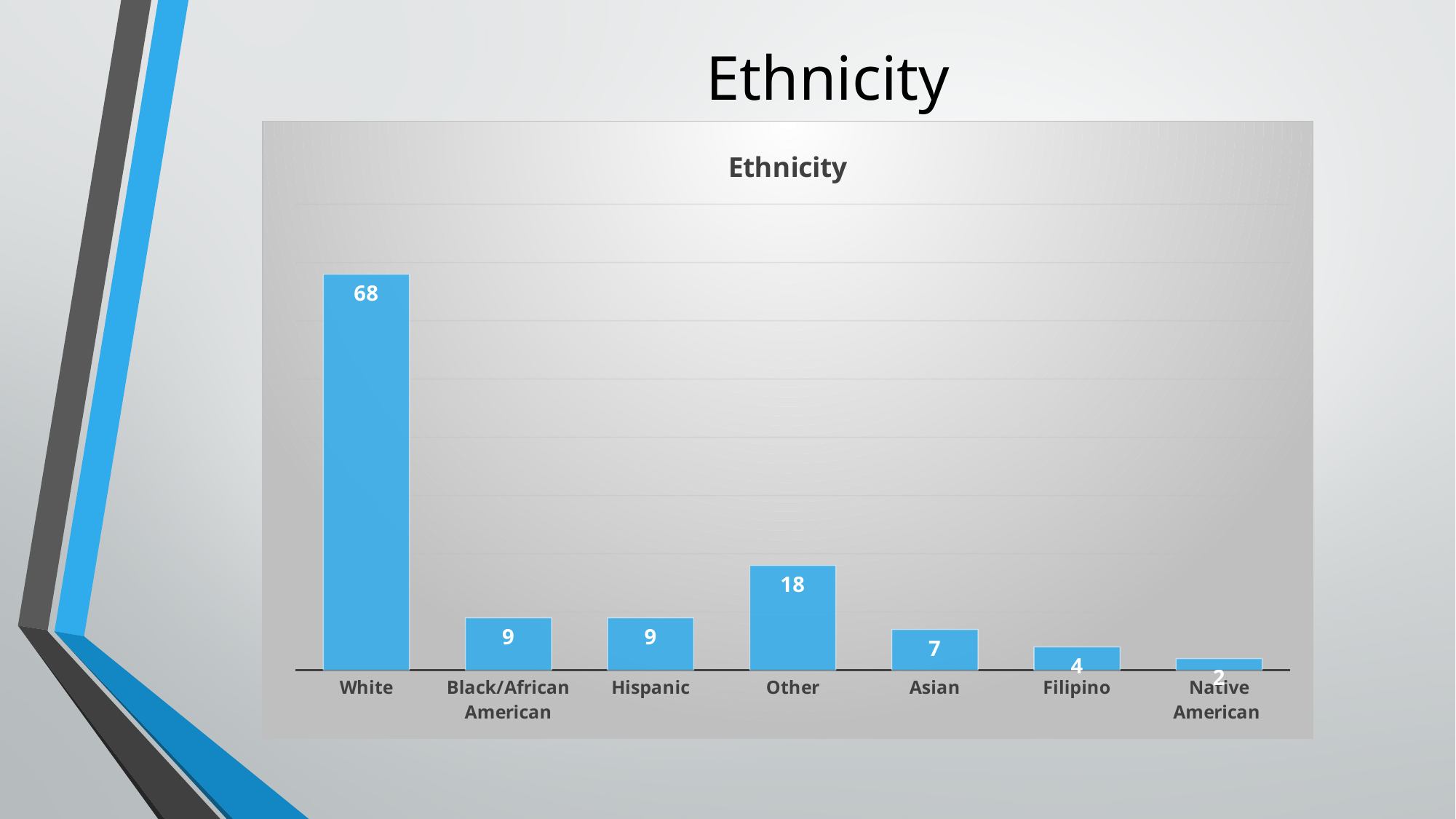
Which category has the highest value? White What kind of chart is this? Bar chart Which category has the lowest value? Native American How many categories are shown on the x axis? 7 What is the title of the chart? Ethnicity Which is larger, the value for Other or the value for Hispanic? Other What is the difference between the values for White and Other? 50 What is the value for Other? 18 What is the difference between the values for Asian and Filipino? 3 What is the value for White? 68 What is the value for Asian? 7 What is the value for Native American? 2